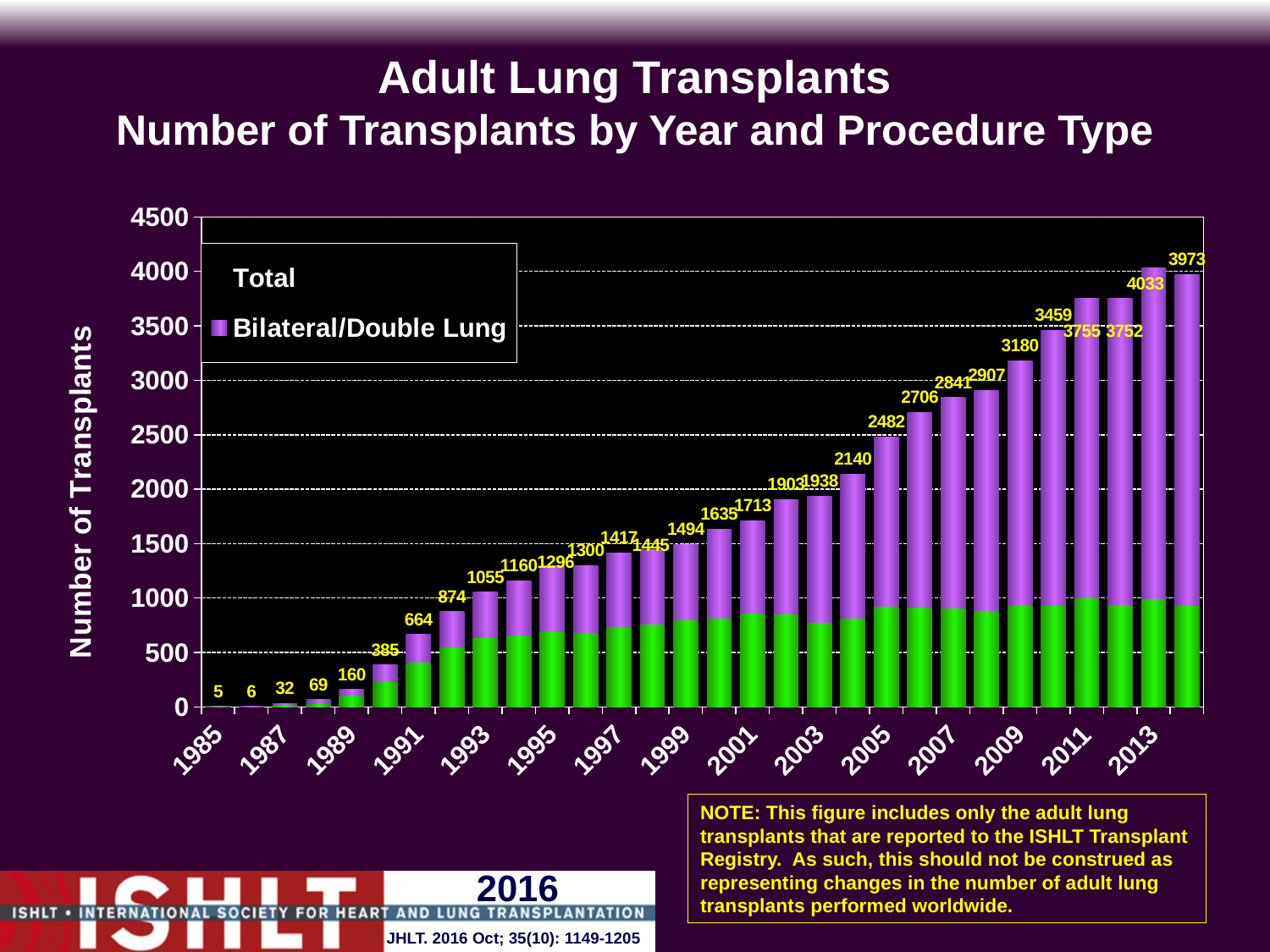
By how much does the total for 2013 exceed the total for 2014? 60 Which year has the larger total, 1999 or 2000? 2000 How many yearly bars are plotted in the chart? 30 Which year has the highest total number of transplants? 2013 What is the total number of adult lung transplants shown for 1991? 664 Which year has the lowest total number of transplants? 1985 What is the difference between the totals for 2005 and 2004? 342 What is the total number of transplants labelled for 2005? 2482 What is the title of the vertical axis? Number of Transplants What kind of chart is shown on the slide? Stacked bar chart Is the green (lower) portion of the 2014 bar greater or less than 1000? less What total is labelled on the bar for 2013? 4033